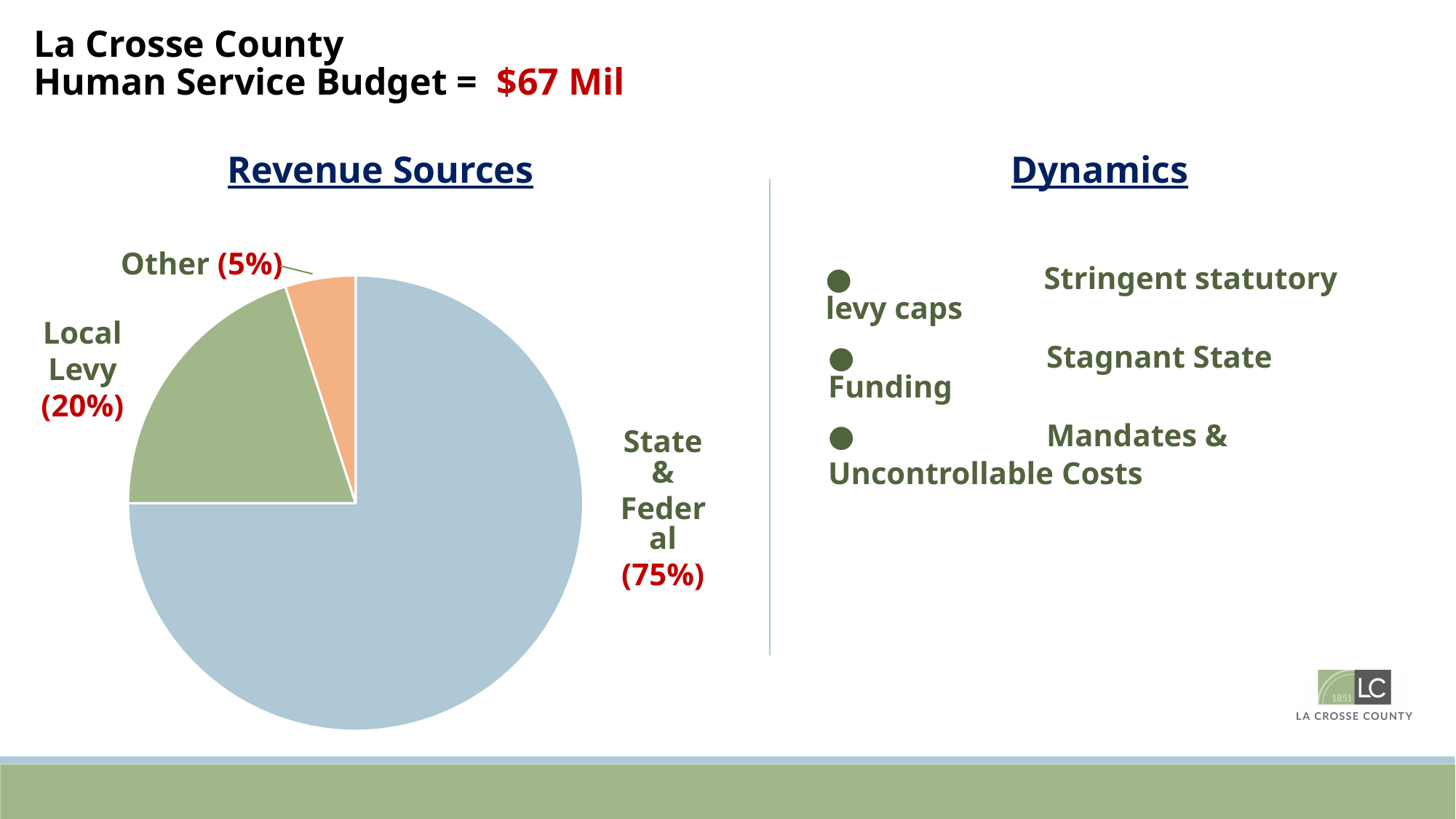
What share of revenue sources comes from State & Federal? 75% How many percentage points larger is the State & Federal share than the Local Levy share? 55 Which is larger, the Local Levy share or the Other share? Local Levy Which revenue source has the smallest share of the pie? Other What share of revenue sources comes from Local Levy? 20% Which revenue source has the largest share of the pie? State & Federal What colour is the State & Federal slice of the pie chart? Light blue What share of revenue sources comes from Other? 5% What kind of chart is used to show Revenue Sources? Pie chart How many percentage points larger is the Local Levy share than the Other share? 15 What is the title of the chart on the slide? Revenue Sources How many slices does the Revenue Sources pie chart have? 3